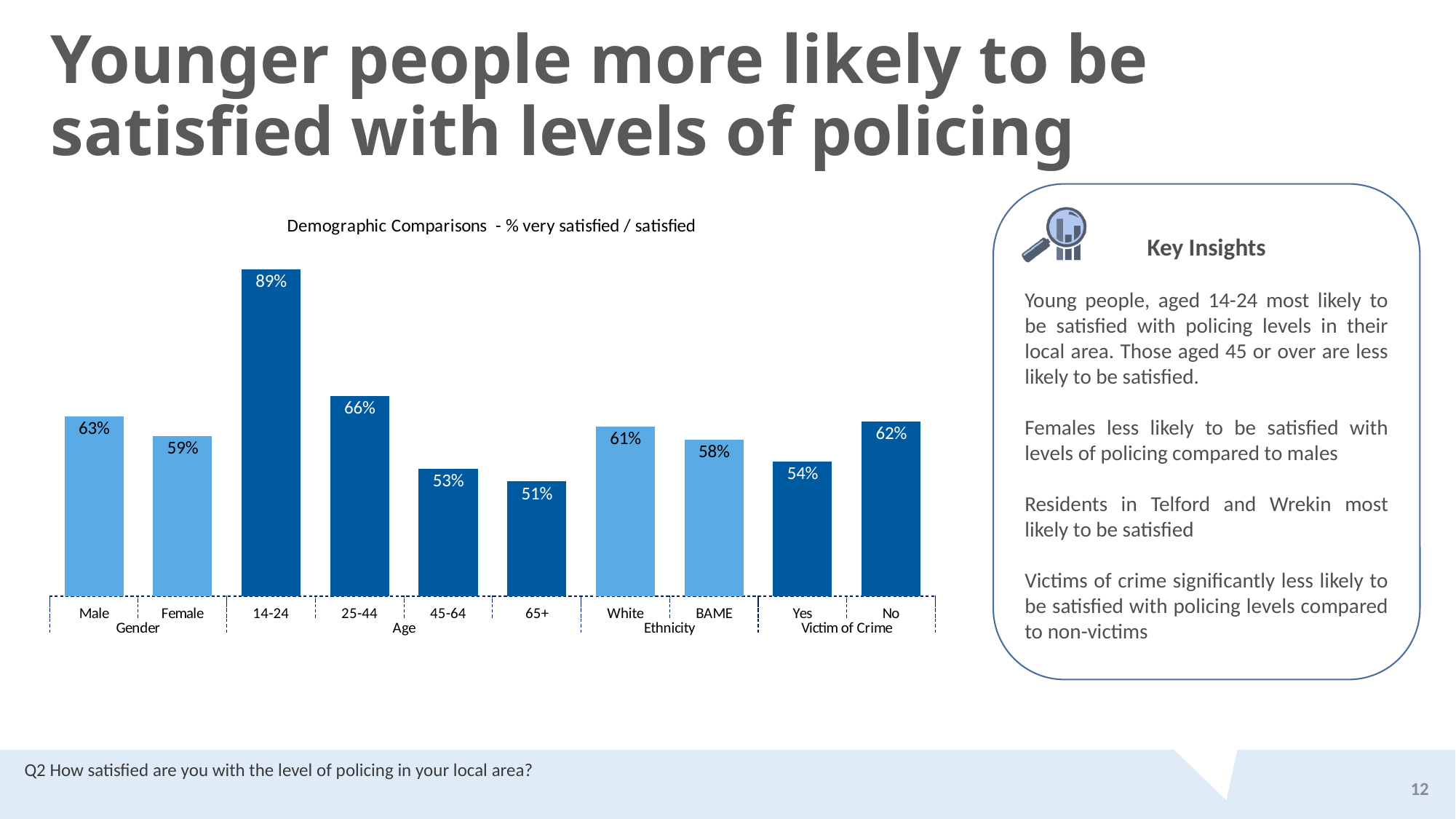
What is the title of the chart? Demographic Comparisons - % very satisfied / satisfied Which category has the lowest value? 65+ Which category has the highest value? 14-24 What kind of chart is shown? Bar chart What is the value for BAME? 58% How many bars are plotted in the chart? 10 What is the difference between the values for 14-24 and 65+? 38% What is the value for the 14-24 age group? 89% What is the value for Male? 63% What is the value for victims of crime (Yes)? 54% Which is larger, the value for White or the value for BAME? White What is the difference between the values for Male and Female? 4%